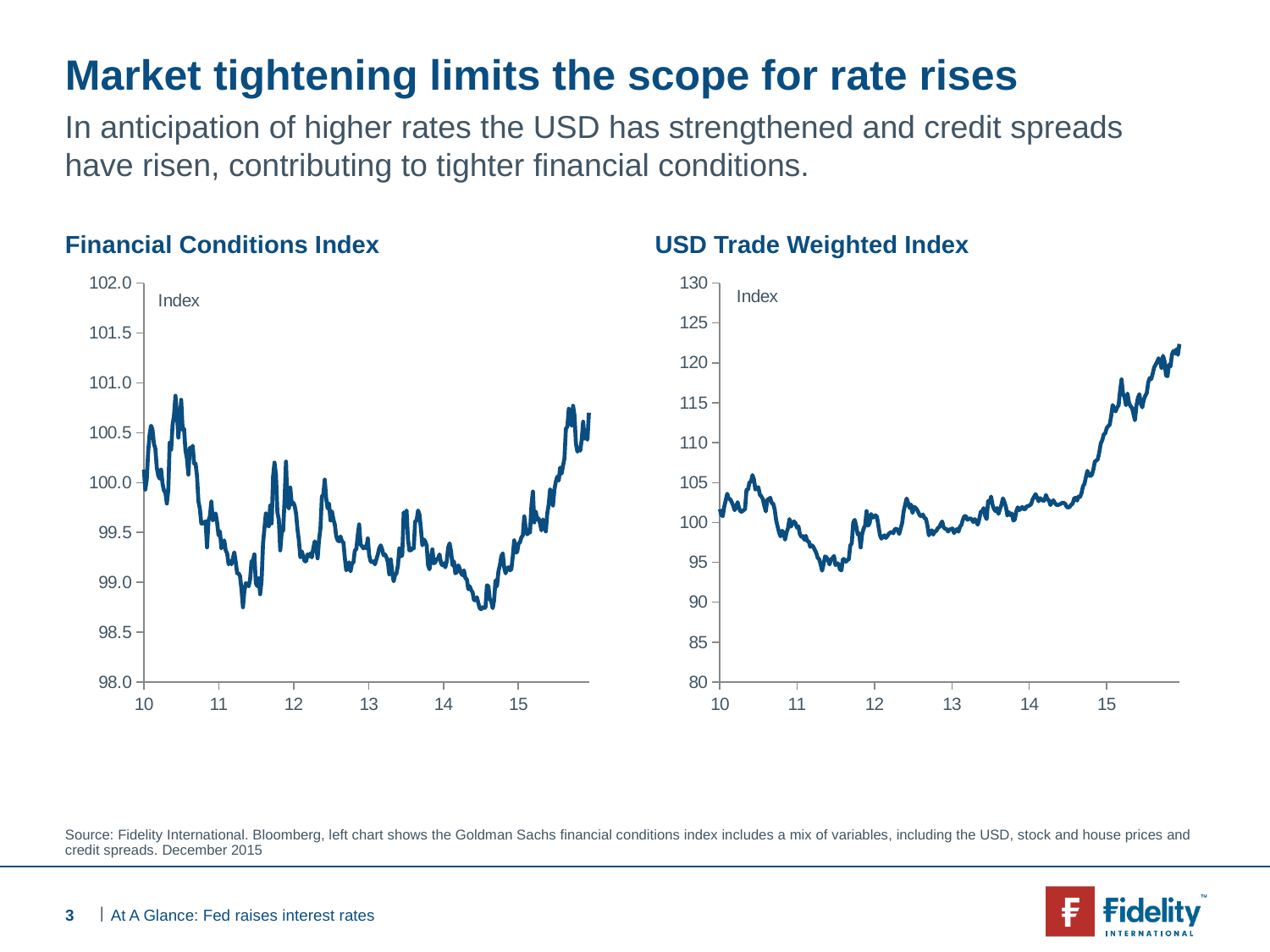
What kind of chart is the Financial Conditions Index chart? line chart What is the title of the chart on the left of the slide? Financial Conditions Index How many year labels are shown on the x axis of the USD Trade Weighted Index chart? 6 In the Financial Conditions Index chart, does the line rise or fall from mid-2014 to the end of 2015? rise What kind of chart is the USD Trade Weighted Index chart? line chart In the USD Trade Weighted Index chart, is the value at the end of 2015 greater or less than 115? greater In the Financial Conditions Index chart, is the value at the end of 2015 greater or less than 100.0? greater In the Financial Conditions Index chart, is the lowest point in 2014 greater or less than 99.5? less In the USD Trade Weighted Index chart, does the line rise or fall between 2014 and the end of 2015? rise What is the highest value shown on the y axis of the USD Trade Weighted Index chart? 130 In the USD Trade Weighted Index chart, is the value at the start of 2010 greater or less than the value at the end of 2015? less